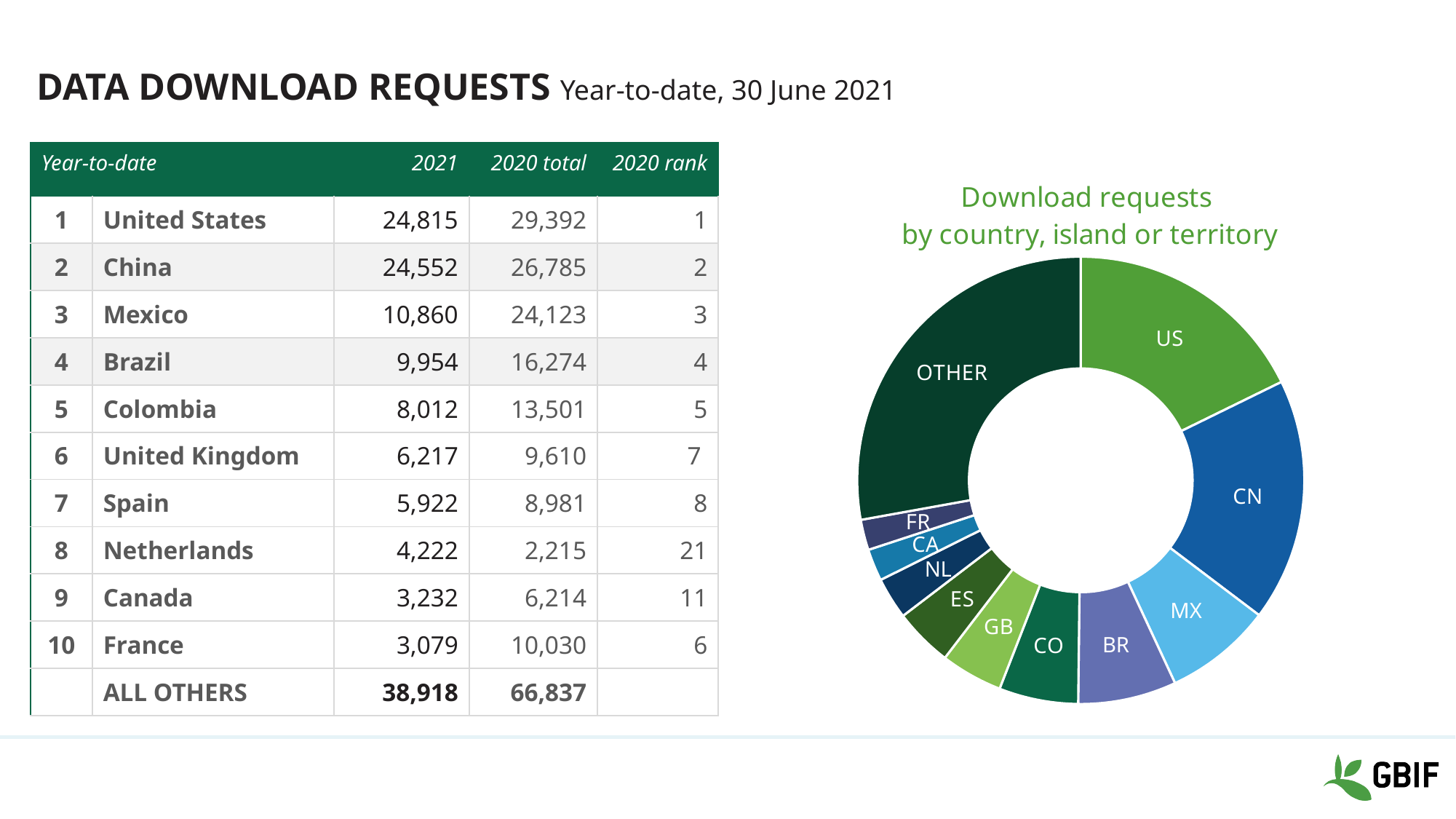
Which country has the largest slice among the individually labelled countries in the donut chart? US Which labelled slice of the donut chart is the smallest? FR In the donut chart, which slice is larger, US or MX? US Which slice of the donut chart is the largest? OTHER According to the table, how many 2021 download requests does the OTHER slice of the donut chart represent? 38,918 What kind of chart is shown on the right of the slide? Donut (pie) chart Which slice of the donut chart is labelled with the code for Brazil? BR In the donut chart, which slice is larger, CO or GB? CO What is the title of the chart on the right? Download requests by country, island or territory According to the table, how many 2021 download requests does the US slice of the donut chart represent? 24,815 Using the table values, what is the difference in 2021 download requests between the US and CN slices? 263 How many slices does the donut chart have? 11